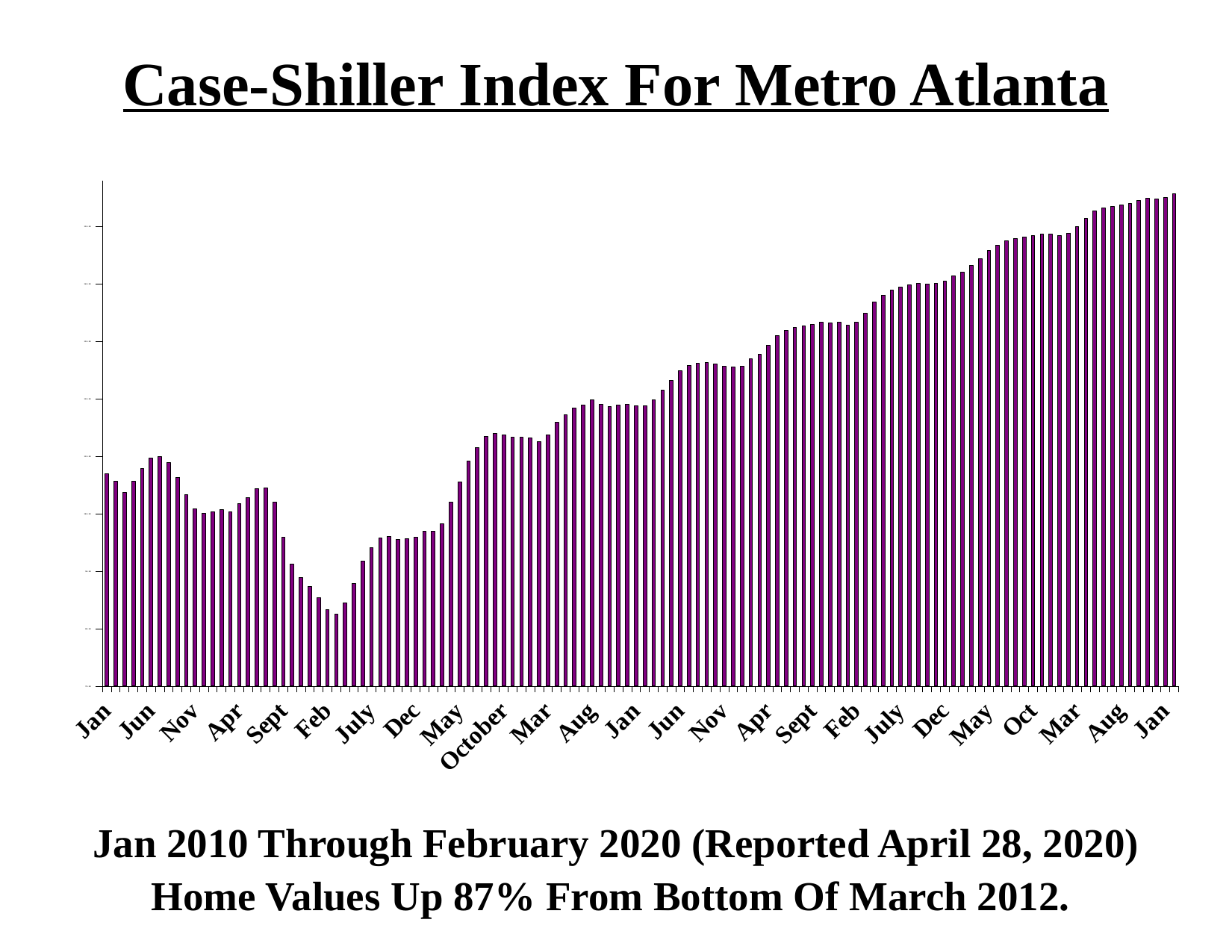
Which is larger: the first bar (Jan 2010) or the last bar (Feb 2020)? the last bar (Feb 2020) What colour are the bars in the chart? purple Overall, do the values rise or fall from the left of the x axis to the right? rise Where is the highest bar located in the chart: at the left end, in the middle, or at the right end? right end Do the values rise or fall between the 'May' label in the middle of the axis and the final 'Jan' label? rise According to the slide, by what percentage are home values up from the bottom of March 2012? 87% Do the values fall or rise between the first 'Jan' label and the second 'Feb' label on the x axis? fall What is the title of the chart? Case-Shiller Index For Metro Atlanta What kind of chart is shown on the slide? bar chart Which is larger: the first bar (Jan 2010) or the lowest bar near the second 'Feb' label? the first bar (Jan 2010) Which month has the lowest bar in the chart? March 2012